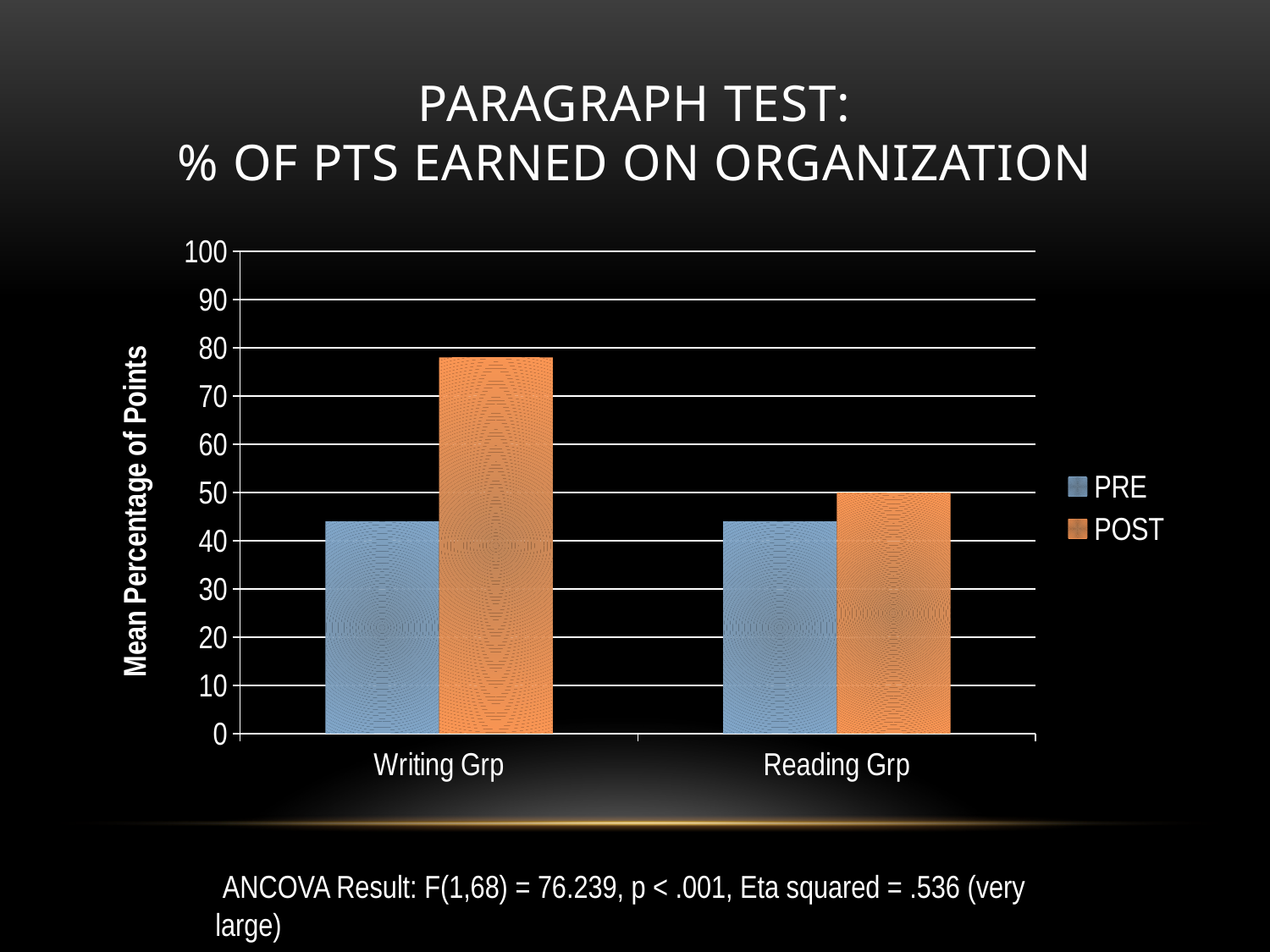
Which is larger, the POST value for Writing Grp or the POST value for Reading Grp? Writing Grp How many series does the legend list? 2 Is the PRE value for Writing Grp greater or less than 50? less For Writing Grp, which is larger, the PRE value or the POST value? POST Is the PRE value for Reading Grp greater or less than 40? greater Is the POST value for Writing Grp greater or less than 70? greater What kind of chart is shown on the slide? bar chart Which group has the highest POST bar? Writing Grp What are the two series named in the legend? PRE and POST How many groups are shown on the x axis? 2 What is the label of the y axis? Mean Percentage of Points